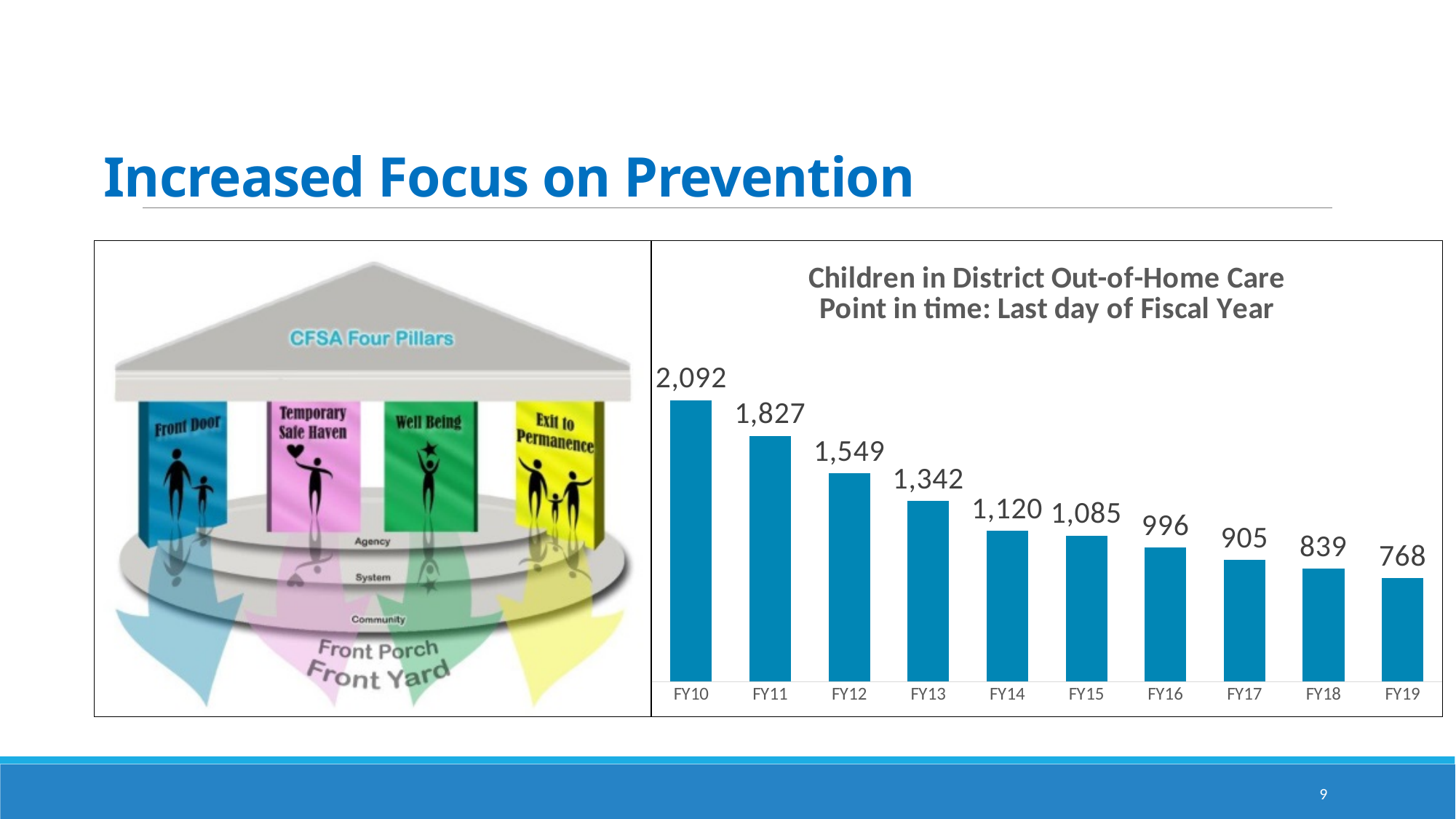
Do the values rise or fall from FY10 to FY19? Fall What kind of chart is shown on the slide? Bar chart What is the value for FY19 in the chart? 768 Which fiscal year has the lowest value in the chart? FY19 Which fiscal year has the highest value in the chart? FY10 How many fiscal years are shown in the chart? 10 What is the difference between the values for FY10 and FY19? 1,324 Which is larger, the value for FY14 or the value for FY16? FY14 What is the value for FY15 in the chart? 1,085 What is the value for FY10 in the chart? 2,092 What is the difference between the values for FY12 and FY13? 207 What is the title of the chart? Children in District Out-of-Home Care Point in time: Last day of Fiscal Year